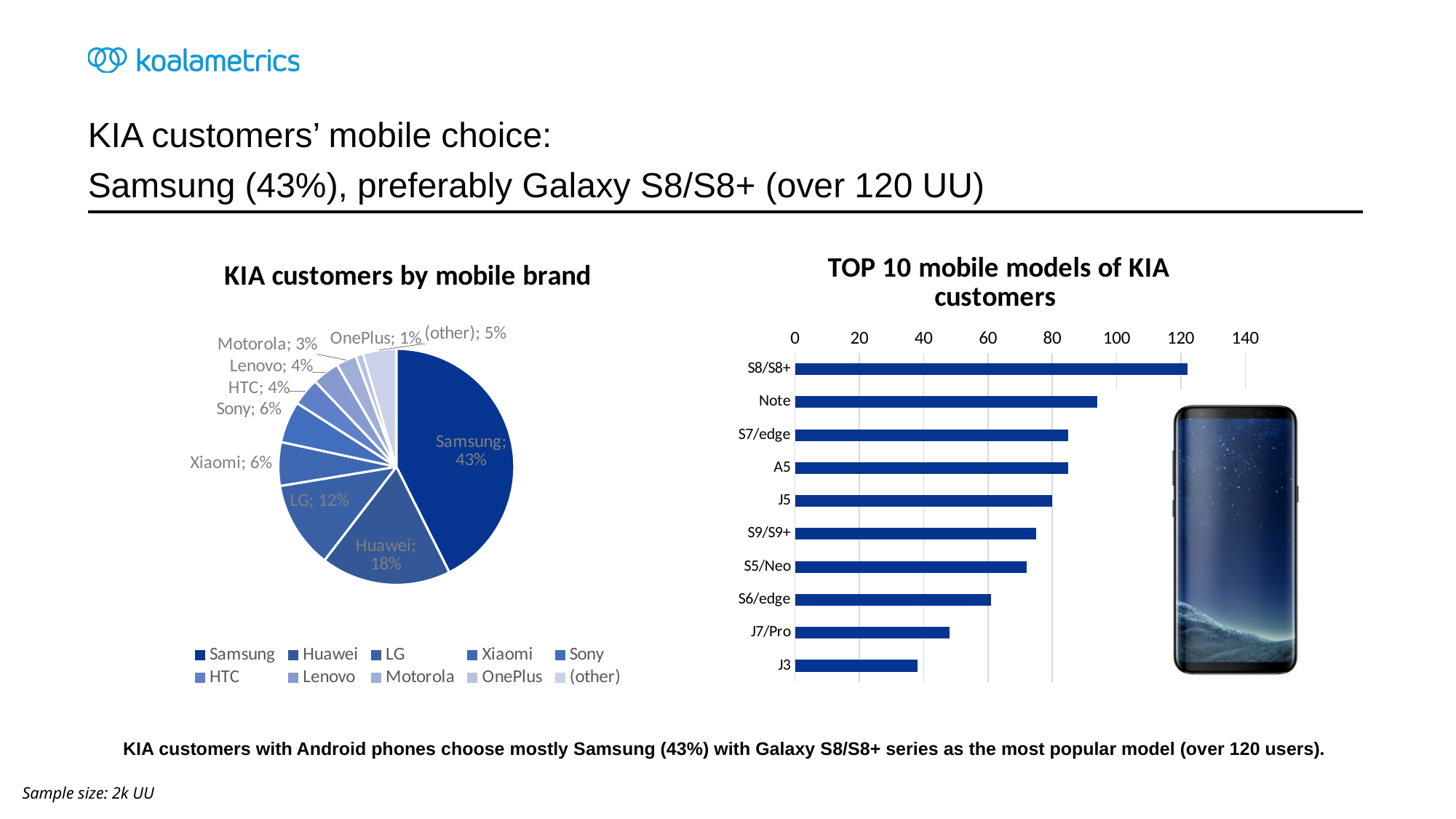
In the 'TOP 10 mobile models of KIA customers' chart, is the value for Note greater or less than 80? greater In the 'KIA customers by mobile brand' chart, what share of KIA customers use Huawei? 18% In the 'KIA customers by mobile brand' chart, what share of KIA customers use Samsung? 43% What kind of chart is 'TOP 10 mobile models of KIA customers'? Bar chart In the 'KIA customers by mobile brand' chart, which has a larger share, Xiaomi or Lenovo? Xiaomi How many entries does the legend of the 'KIA customers by mobile brand' chart list? 10 In the 'KIA customers by mobile brand' chart, what is the difference in percentage points between Samsung and Huawei? 25 In the 'KIA customers by mobile brand' chart, what share of KIA customers use LG? 12% In the 'TOP 10 mobile models of KIA customers' chart, which model has the highest value? S8/S8+ In the 'KIA customers by mobile brand' chart, which brand has the largest share? Samsung In the 'KIA customers by mobile brand' chart, which brand has the smallest share? OnePlus